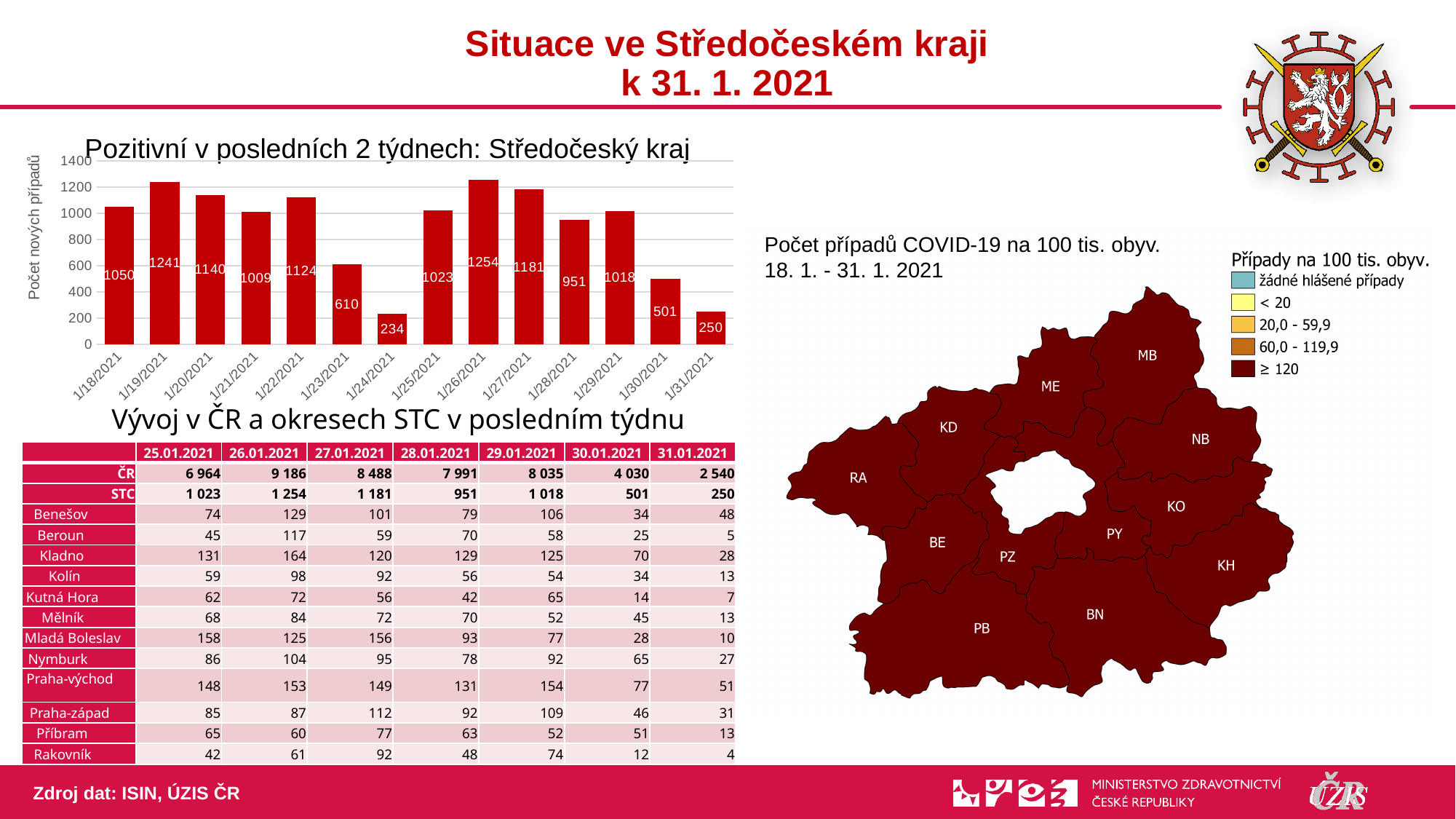
What is the value for 1/24/2021 in the bar chart? 234 What is the difference between the values for 1/19/2021 and 1/20/2021 in the bar chart? 101 What is the label on the vertical axis of the bar chart? Počet nových případů Which date has the lowest value in the bar chart? 1/24/2021 What is the difference between the values for 1/26/2021 and 1/24/2021 in the bar chart? 1020 What is the value for 1/30/2021 in the bar chart? 501 What is the value for 1/18/2021 in the bar chart? 1050 Do the values in the bar chart rise or fall from 1/26/2021 to 1/31/2021? fall How many dates (bars) are plotted in the bar chart? 14 What type of chart is shown under the title 'Pozitivní v posledních 2 týdnech: Středočeský kraj'? bar chart Which date has the highest value in the bar chart? 1/26/2021 Which is larger in the bar chart, the value for 1/23/2021 or the value for 1/30/2021? 1/23/2021